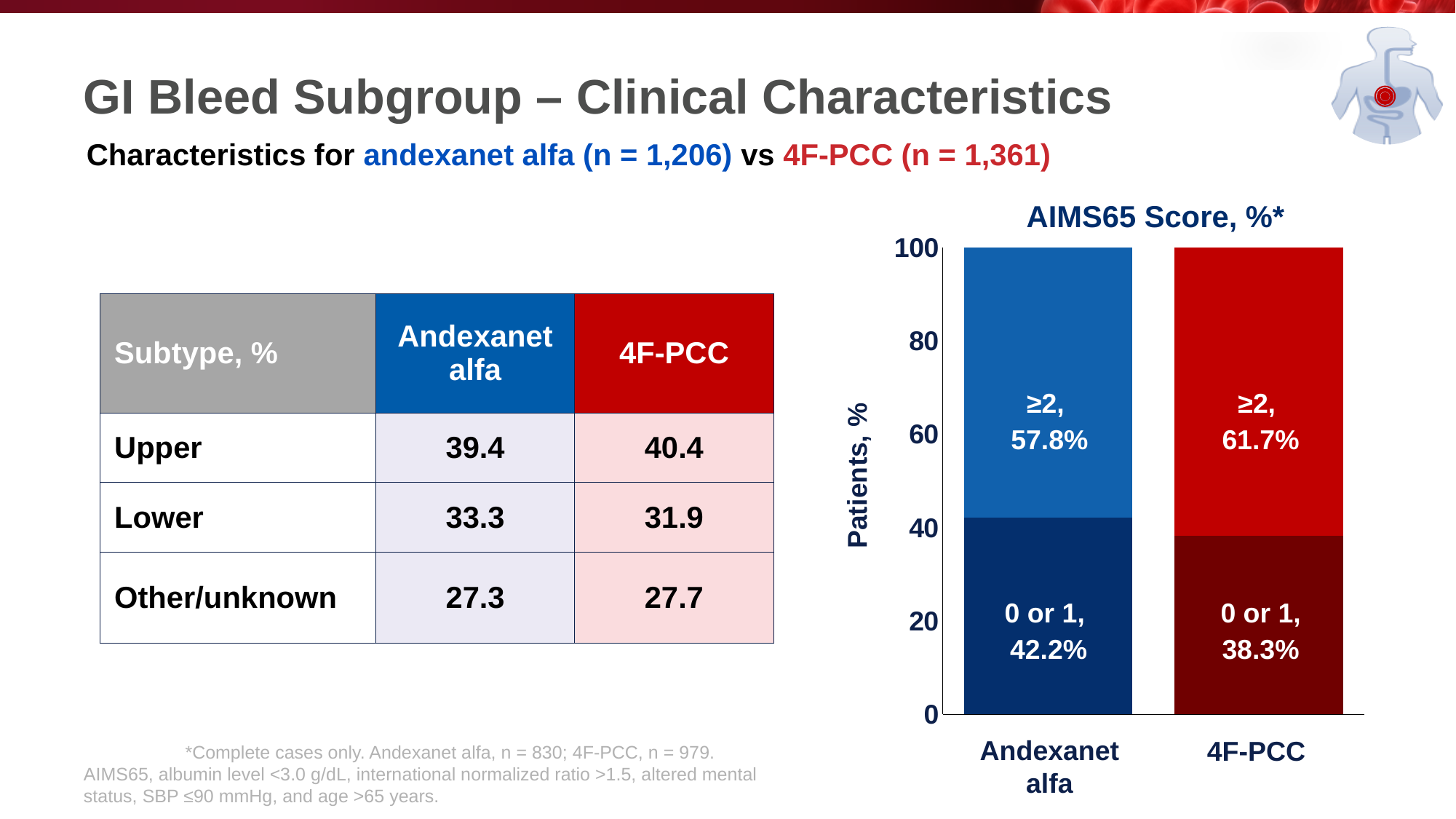
In the AIMS65 Score chart, which group has the larger share of patients with a score of 0 or 1? Andexanet alfa In the AIMS65 Score chart, what percentage of andexanet alfa patients had a score of ≥2? 57.8% In the AIMS65 Score chart, what is the total of the two segments in the andexanet alfa bar? 100% What type of chart is the AIMS65 Score chart? Stacked bar chart What is the y-axis label of the AIMS65 Score chart? Patients, % In the AIMS65 Score chart, what percentage of 4F-PCC patients had a score of 0 or 1? 38.3% In the AIMS65 Score chart, what is the difference in percentage points between the 0 or 1 shares for andexanet alfa and 4F-PCC? 3.9 How many bars (treatment groups) are shown in the AIMS65 Score chart? 2 In the AIMS65 Score chart, what is the difference in percentage points between the ≥2 shares for 4F-PCC and andexanet alfa? 3.9 In the AIMS65 Score chart, what percentage of 4F-PCC patients had a score of ≥2? 61.7% In the AIMS65 Score chart, which group has the larger share of patients with a score of ≥2, andexanet alfa or 4F-PCC? 4F-PCC In the AIMS65 Score chart, what percentage of andexanet alfa patients had a score of 0 or 1? 42.2%